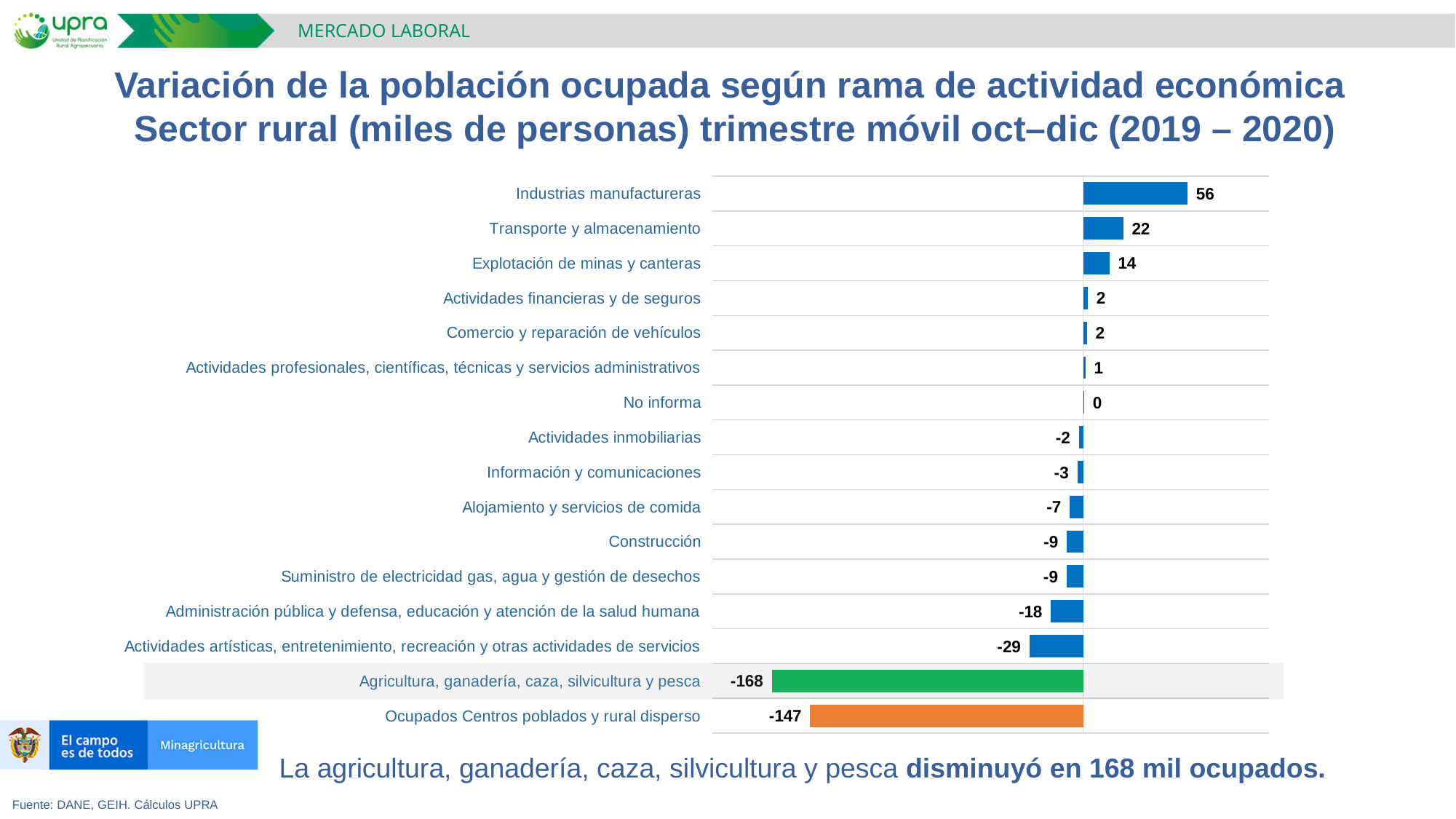
What is the difference between the values for Industrias manufactureras and Transporte y almacenamiento? 34 Which category has the highest value? Industrias manufactureras What is the value for Ocupados Centros poblados y rural disperso? -147 Which is larger, the value for Explotación de minas y canteras or the value for Transporte y almacenamiento? Transporte y almacenamiento How many categories are shown in the chart? 16 What is the value for Transporte y almacenamiento? 22 What is the value for Industrias manufactureras? 56 What kind of chart is shown on the slide? Bar chart What is the value for Administración pública y defensa, educación y atención de la salud humana? -18 What colour is the bar for Ocupados Centros poblados y rural disperso? Orange Which category has the lowest value? Agricultura, ganadería, caza, silvicultura y pesca What is the value for Agricultura, ganadería, caza, silvicultura y pesca? -168